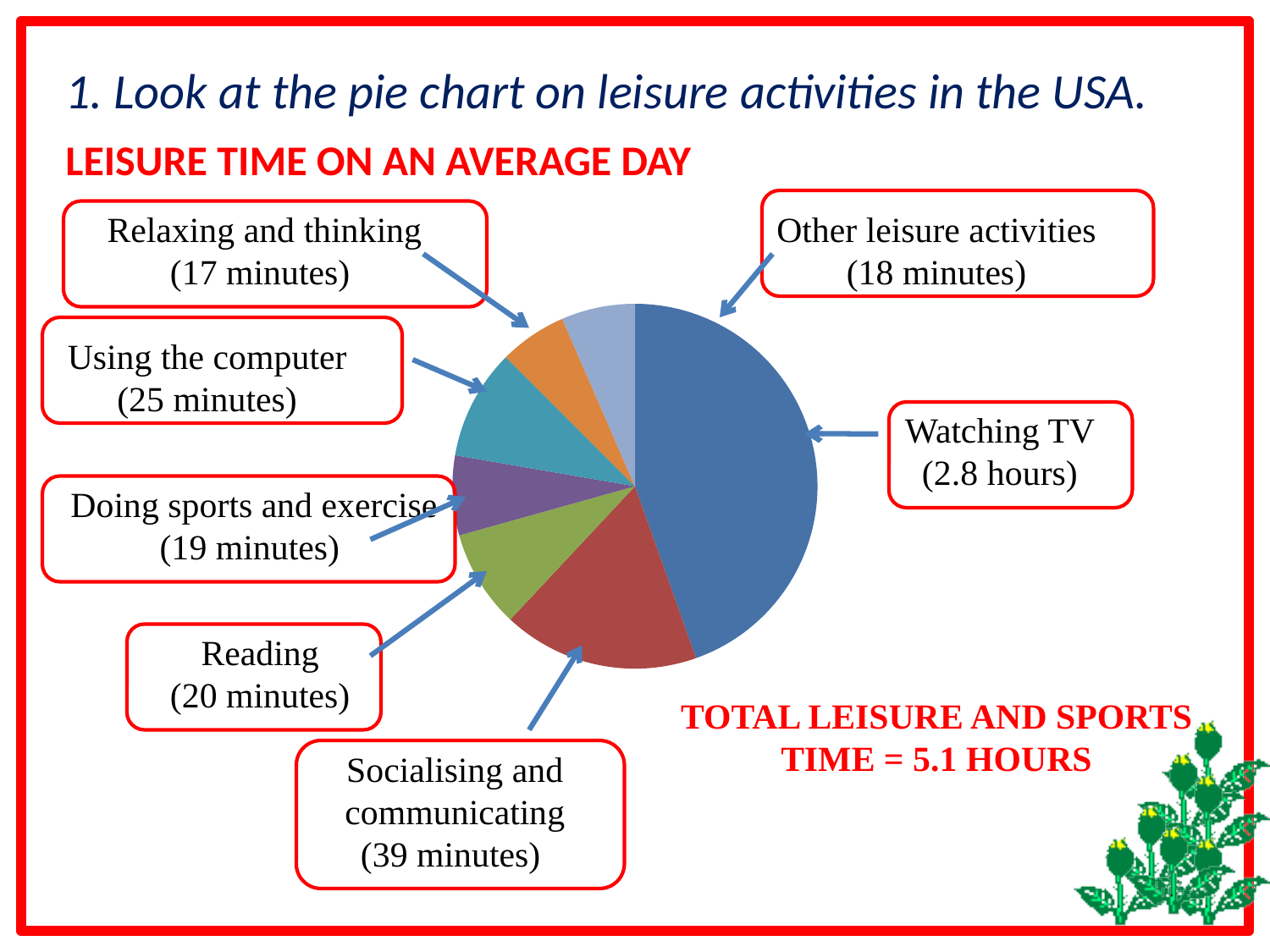
How many slices does the pie chart have? 7 Which takes more time: using the computer or doing sports and exercise? Using the computer What is the title of the chart? LEISURE TIME ON AN AVERAGE DAY What is the total leisure and sports time stated on the slide? 5.1 hours How much time is spent socialising and communicating? 39 minutes Which activity takes up the least leisure time? Relaxing and thinking What kind of chart is shown on the slide? pie chart How much time is spent using the computer? 25 minutes How much time is spent on other leisure activities? 18 minutes Which activity takes up the largest share of leisure time? Watching TV How much time is spent watching TV on an average day? 2.8 hours How many more minutes are spent socialising and communicating than reading? 19 minutes